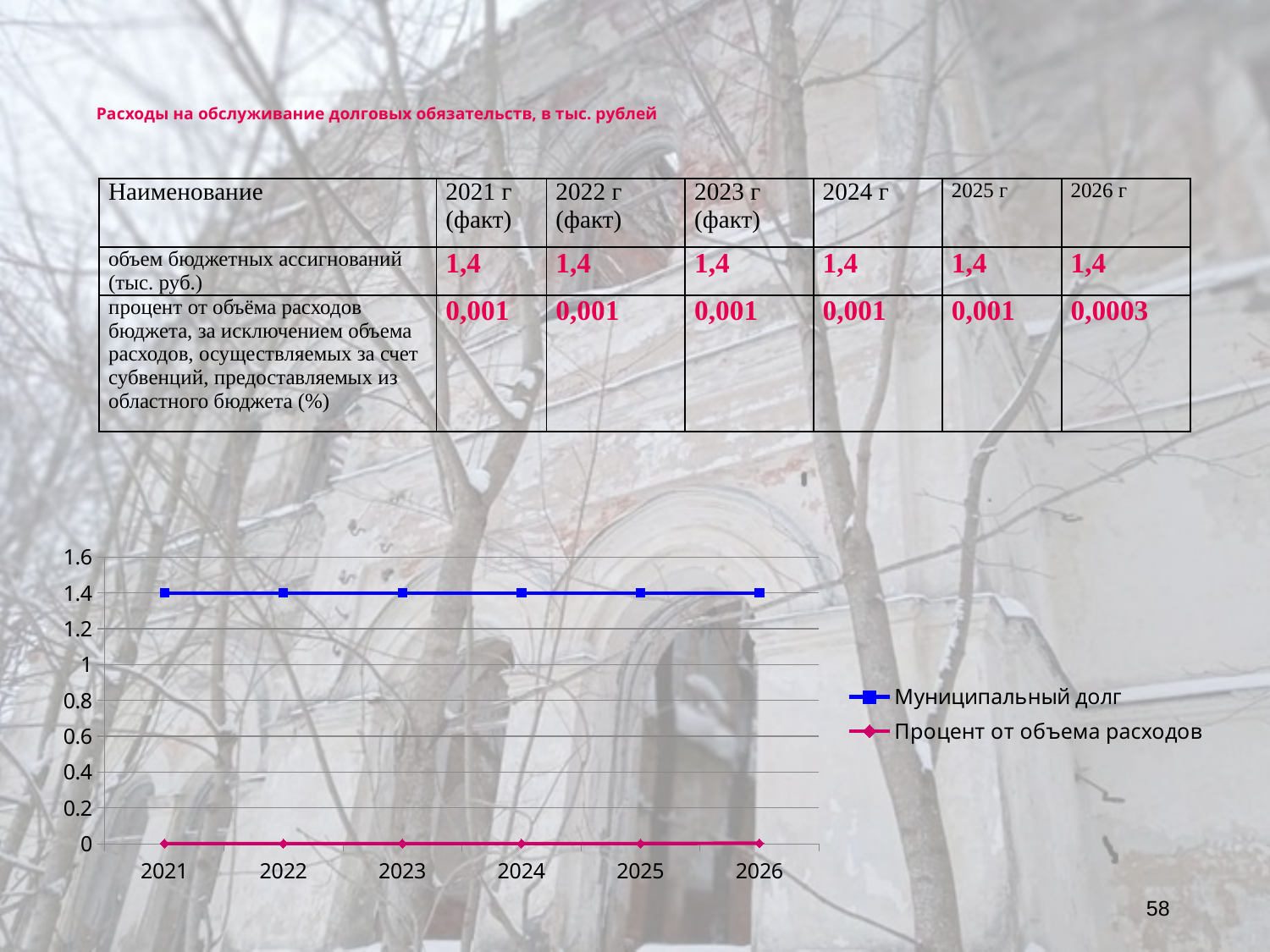
Does the Муниципальный долг series rise, fall or stay flat from 2021 to 2026? stays flat What is the value of the Муниципальный долг series in 2021? 1.4 How many years are plotted along the x axis of the chart? 6 Which series is drawn in blue on the chart? Муниципальный долг What kind of chart is shown on the slide? line chart Is the value of the Процент от объема расходов series in 2024 greater or less than 0.2? less What is the highest value shown on the y axis of the chart? 1.6 Which series has the higher value in 2025, Муниципальный долг or Процент от объема расходов? Муниципальный долг Is the value of the Муниципальный долг series in 2023 greater or less than 1? greater What is the value of the Муниципальный долг series in 2026? 1.4 How many series does the chart legend list? 2 What is the first year shown on the x axis of the chart? 2021